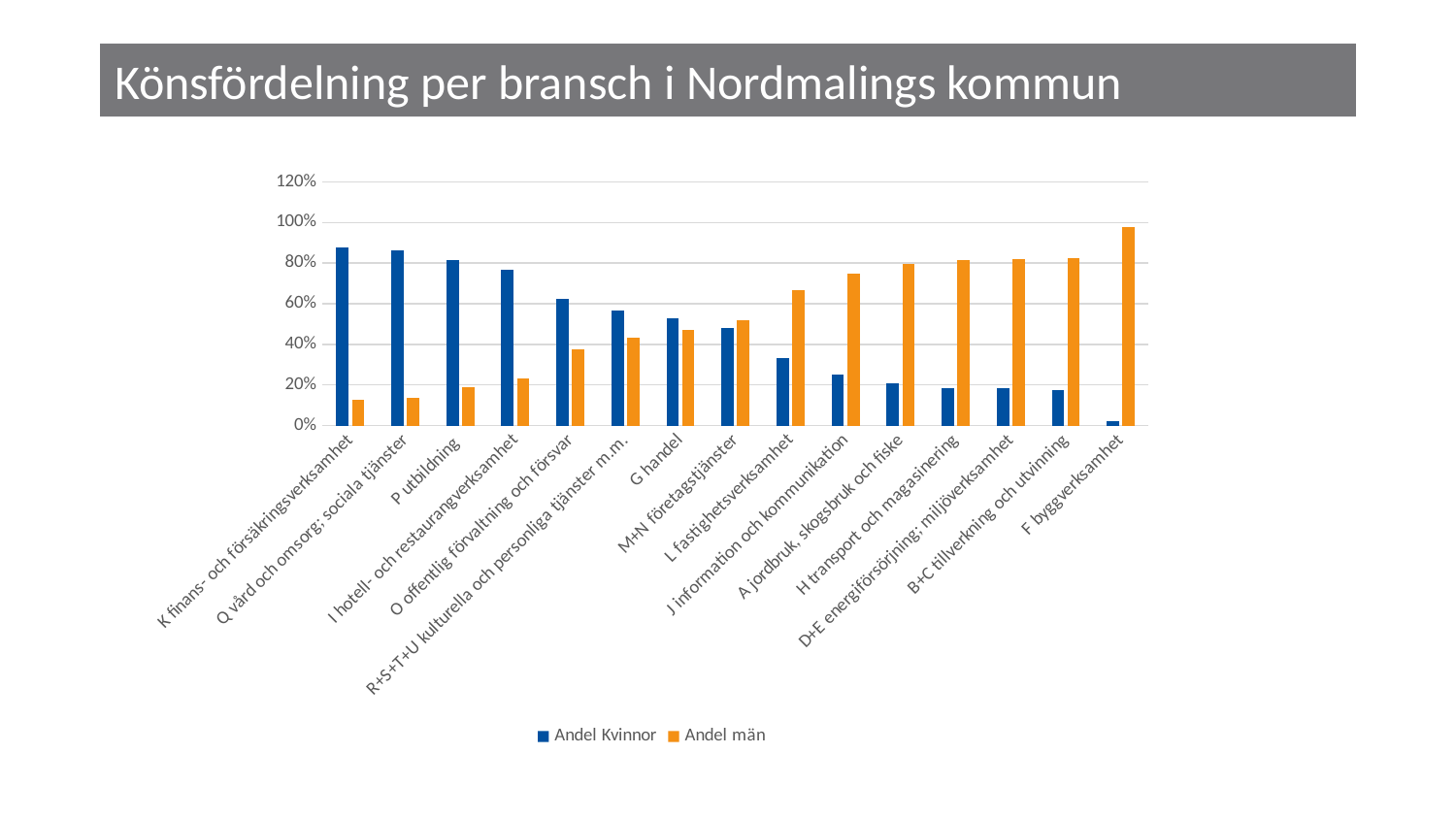
Is the value for Andel män in K finans- och försäkringsverksamhet greater or less than 20%? less How many series does the legend list? 2 What kind of chart is shown on the slide? bar chart What is the title of the chart? Könsfördelning per bransch i Nordmalings kommun For J information och kommunikation, which is larger: Andel Kvinnor or Andel män? Andel män Which category has the lowest value for Andel Kvinnor? F byggverksamhet Is the value for Andel Kvinnor in O offentlig förvaltning och försvar greater or less than 40%? greater How many industry categories are plotted on the x axis? 15 Do the values for Andel Kvinnor rise or fall from left to right along the x axis? fall Is the value for Andel män in F byggverksamhet greater or less than 80%? greater Which category has the highest value for Andel män? F byggverksamhet